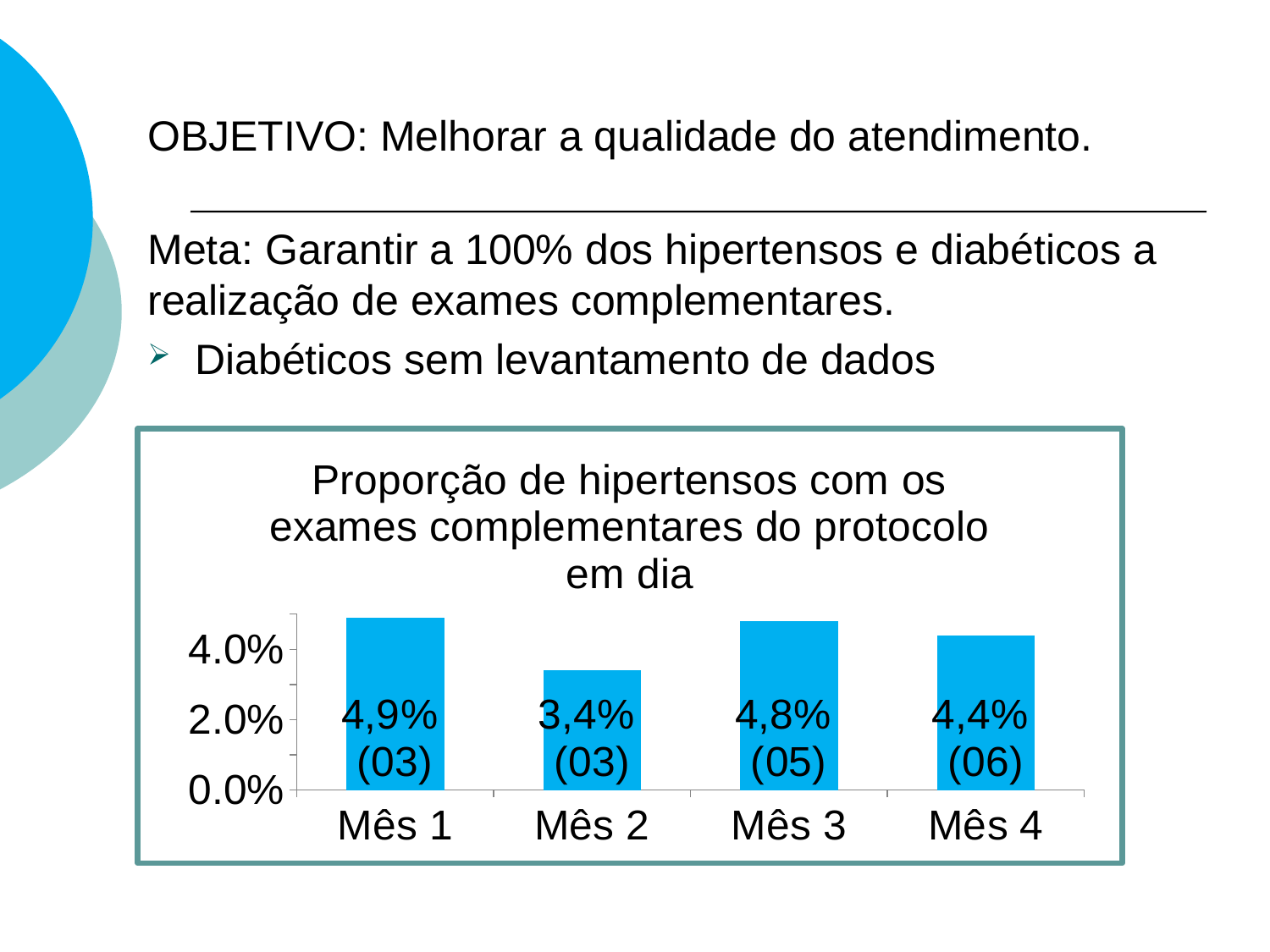
Which month has the lowest value? Mês 2 Which is larger, the value for Mês 3 or the value for Mês 4? Mês 3 What is the value shown for Mês 1? 4,9% What is the value shown for Mês 3? 4,8% How many months are shown on the x axis? 4 What number is shown in parentheses under the value for Mês 4? (06) What is the difference between the values for Mês 1 and Mês 2? 1,5% Is the value for Mês 2 greater or less than 4.0%? less What is the value shown for Mês 4? 4,4% Which month has the highest value? Mês 1 What is the value shown for Mês 2? 3,4% What kind of chart is shown on the slide? bar chart